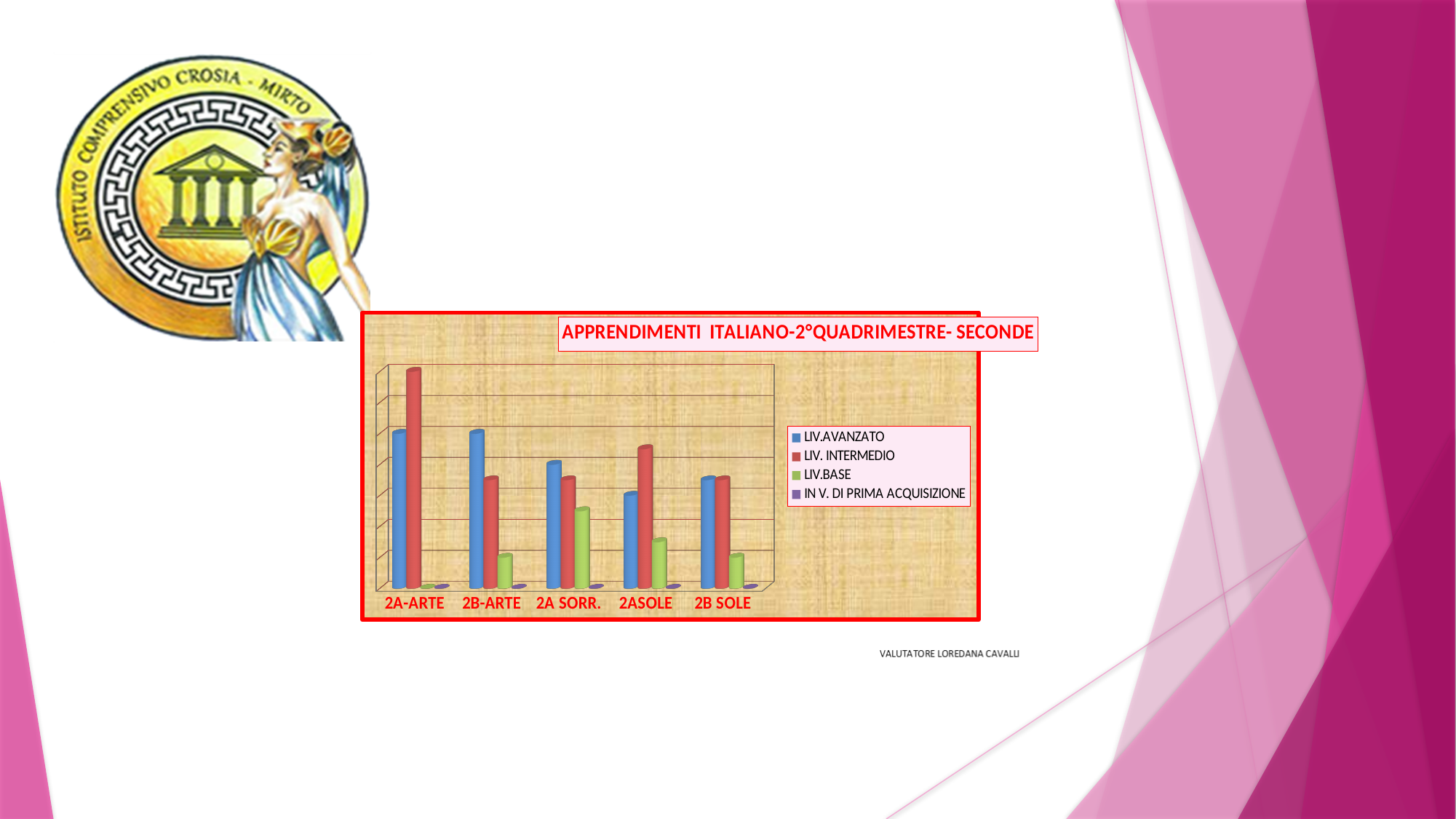
For 2ASOLE, which is larger: LIV.AVANZATO or LIV. INTERMEDIO? LIV. INTERMEDIO What is the title of the chart? APPRENDIMENTI ITALIANO-2°QUADRIMESTRE- SECONDE Which series is shown in green in the chart? LIV.BASE What kind of chart is shown on the slide? bar chart How many class categories are shown on the x axis of the chart? 5 For 2A-ARTE, which is larger: LIV.AVANZATO or LIV. INTERMEDIO? LIV. INTERMEDIO For 2A SORR., which is larger: LIV. INTERMEDIO or LIV.BASE? LIV. INTERMEDIO Which class has the lowest LIV.BASE bar? 2A-ARTE Which class has the highest LIV. INTERMEDIO bar? 2A-ARTE Which class has the highest LIV.BASE bar? 2A SORR. How many series does the chart legend list? 4